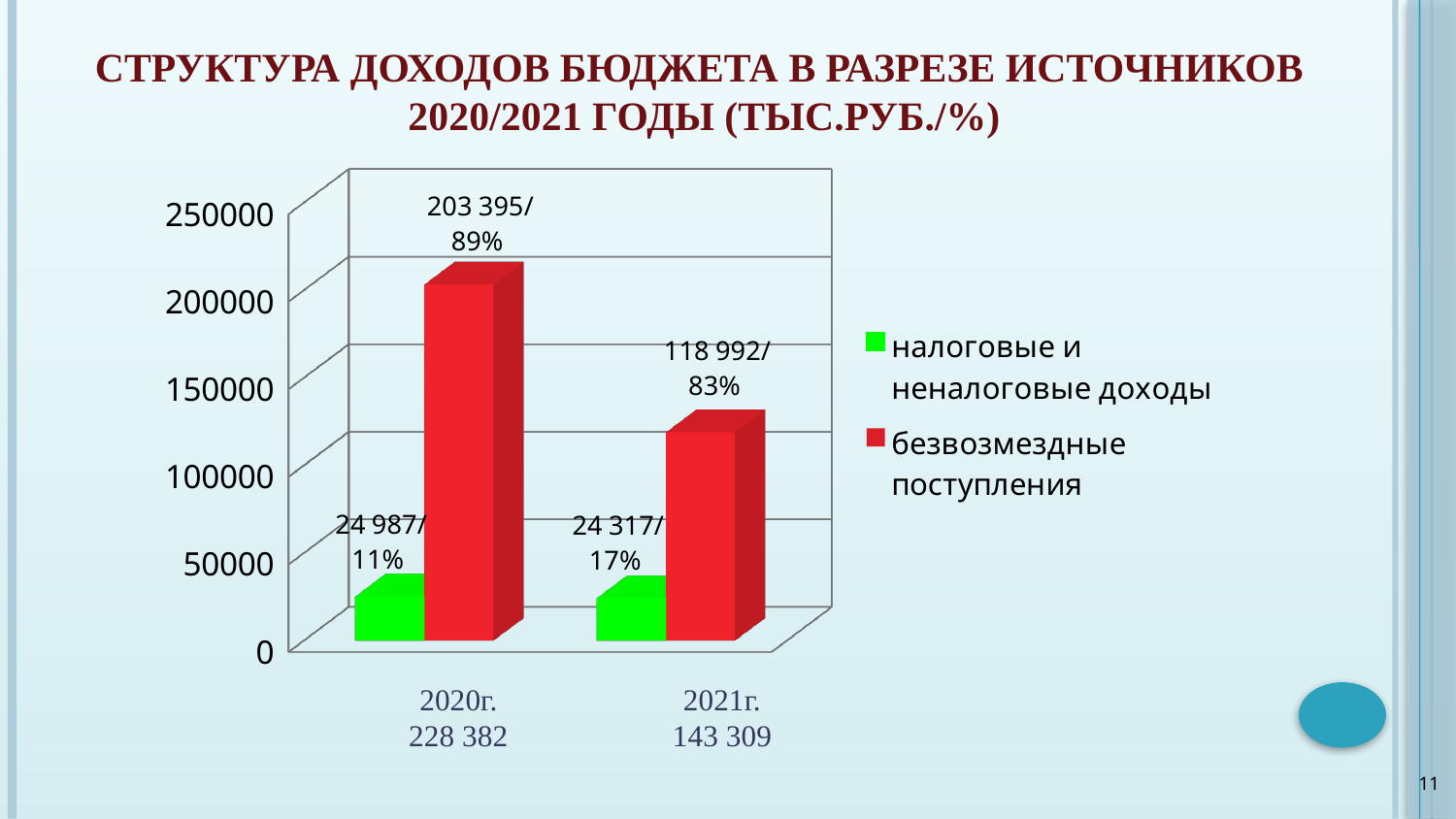
Which bar is the lowest on the chart? налоговые и неналоговые доходы in 2021г. What colour are the bars for безвозмездные поступления? red Which series has the tallest bar on the chart? безвозмездные поступления What is the data label for налоговые и неналоговые доходы in 2021г.? 24 317/ 17% Is the value for безвозмездные поступления in 2021г. greater or less than 150000? less What is the data label for безвозмездные поступления in 2021г.? 118 992/ 83% Which is larger: безвозмездные поступления in 2020г. or in 2021г.? 2020г. What kind of chart is shown on the slide? bar chart How many series does the legend list? 2 What is the data label for безвозмездные поступления in 2020г.? 203 395/ 89% How many year categories are shown on the x axis? 2 What is the data label for налоговые и неналоговые доходы in 2020г.? 24 987/ 11%